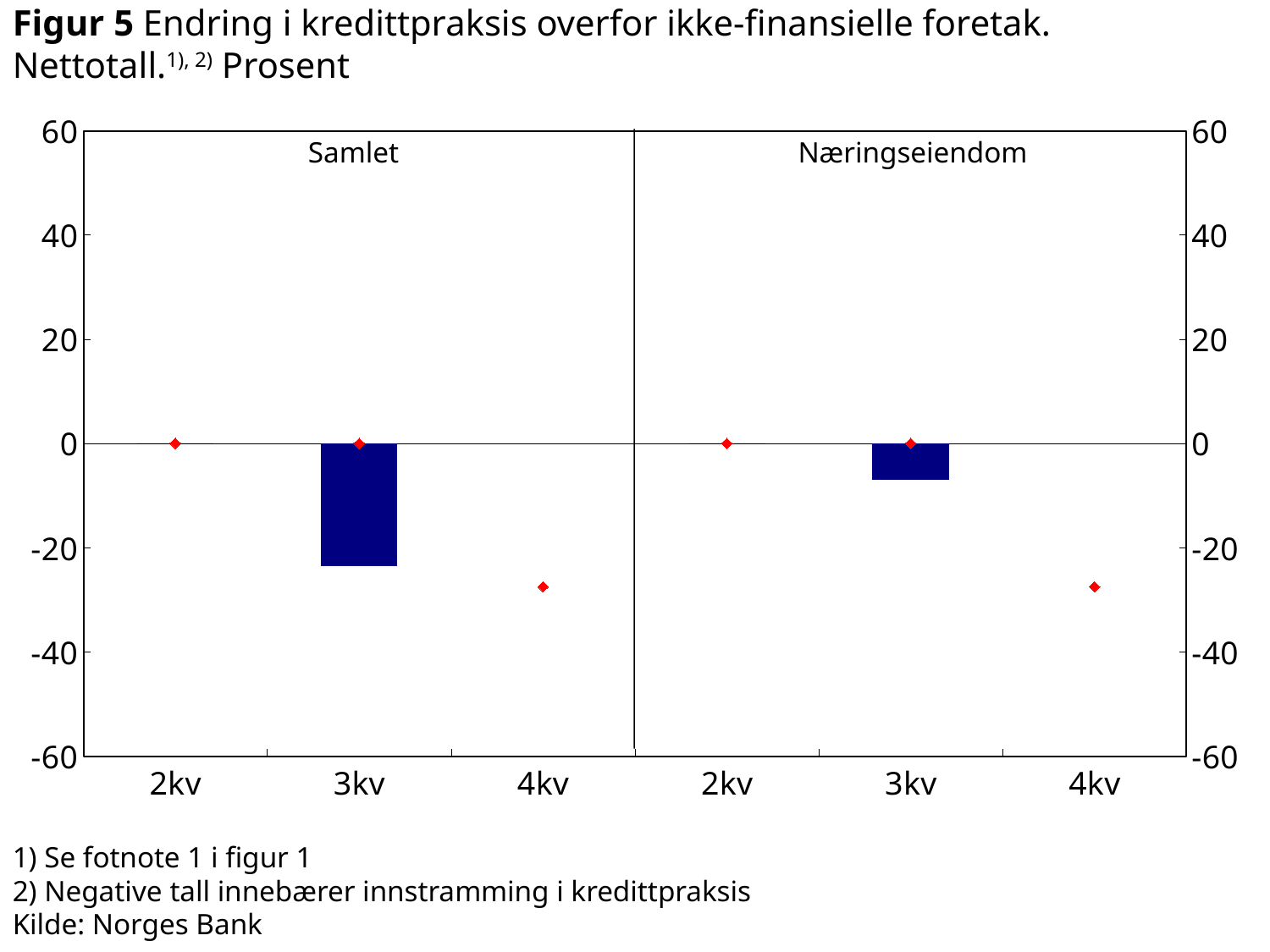
In the Næringseiendom panel, is the red diamond for 4kv greater or less than -20? less Which panel has the larger (more negative) bar at 3kv, Samlet or Næringseiendom? Samlet In the Næringseiendom panel, is the bar value for 3kv greater or less than -20? greater What are the two panel labels shown inside the chart? Samlet and Næringseiendom What is the maximum value shown on the y axis? 60 In the Samlet panel, is the red diamond for 4kv greater or less than -20? less In the Samlet panel, is the bar for 3kv above or below the red diamond for 4kv? above What kind of chart is shown in Figur 5? combination bar and line chart (bars with diamond markers) How many quarters are shown on the x axis of each panel? 3